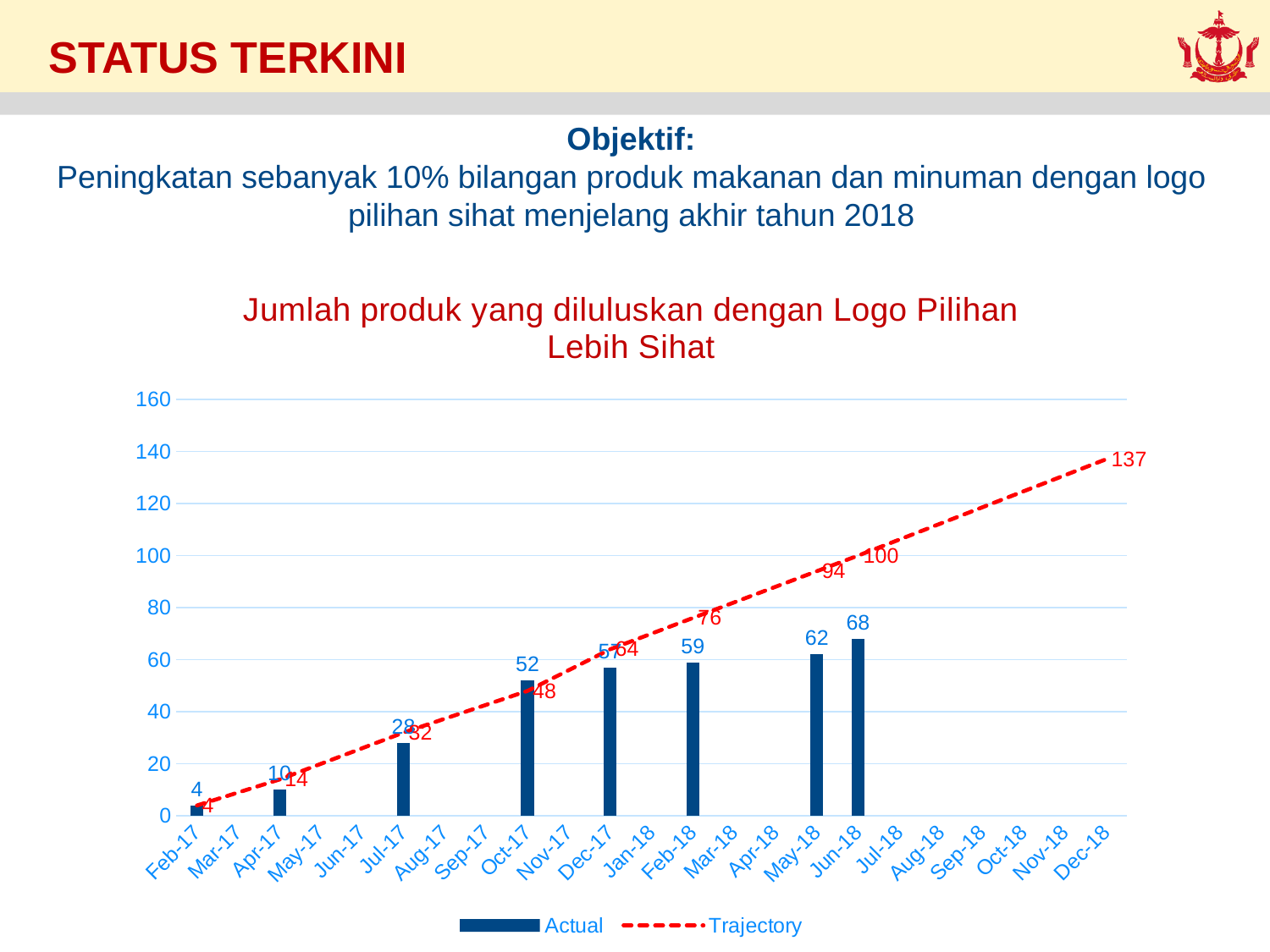
What is the Actual value for Jun-18? 68 What are the two entries in the chart legend? Actual and Trajectory Which is larger, the Actual value for May-18 or the Actual value for Feb-18? May-18 Which month has the highest Actual bar? Jun-18 By how much does the Actual value for Jun-18 exceed the Actual value for Feb-17? 64 Is the Actual value for Oct-17 greater or less than 40? greater What is the Trajectory value for Dec-18? 137 Which month has the lowest Actual bar? Feb-17 How many series does the legend list? 2 Do the Actual bars rise or fall from Feb-17 to Jun-18? rise What is the difference between the Trajectory value and the Actual value for Jun-18? 32 What is the Actual value for Feb-18? 59